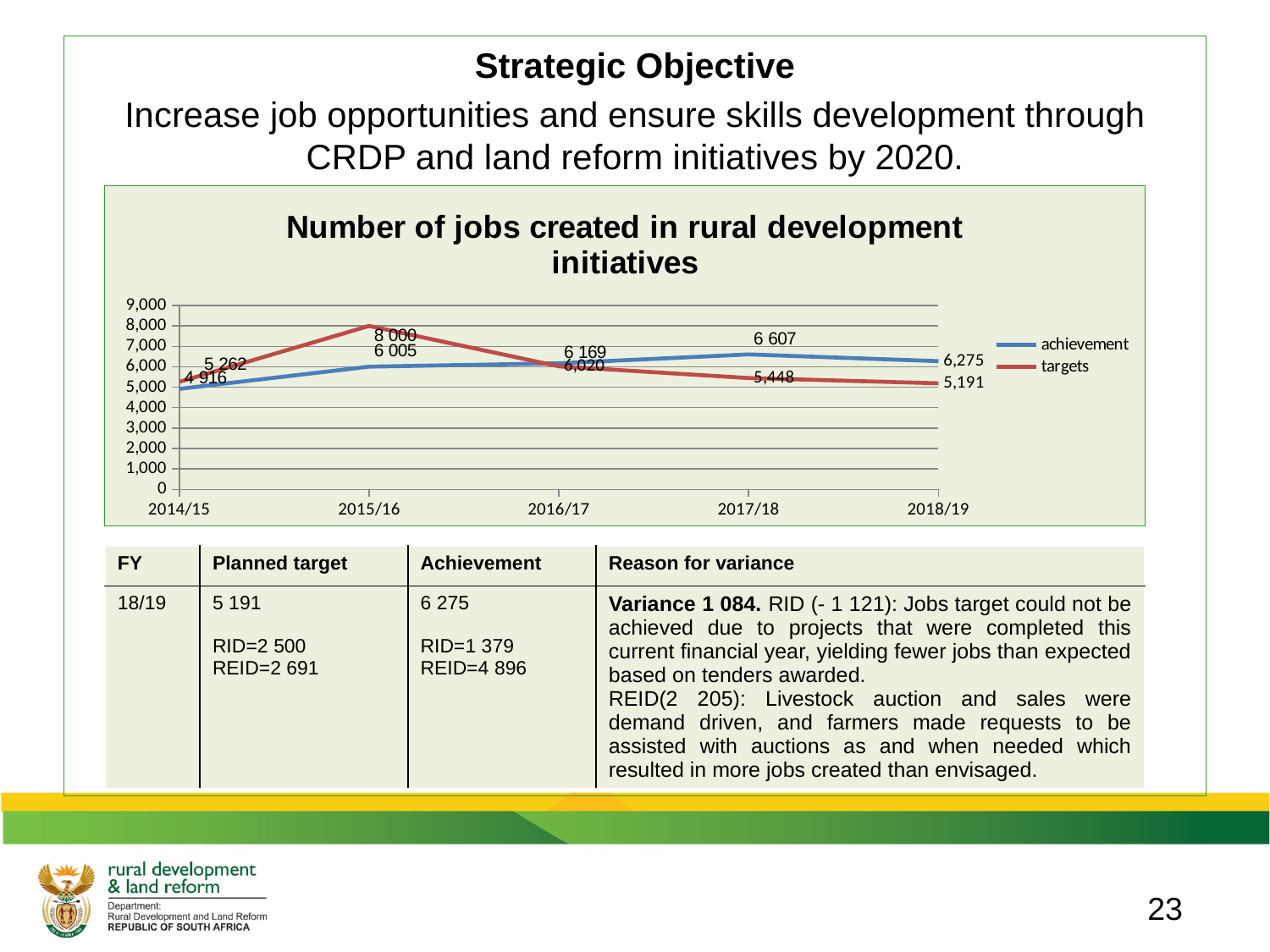
How many financial years are plotted along the x axis of the chart? 5 What is the achievement value for 2018/19? 6,275 What kind of chart is shown on the slide? line chart In which financial year is the achievement series highest? 2017/18 In 2015/16, which is larger: achievement or targets? targets How many series does the legend of the chart list? 2 What is the targets value for 2018/19? 5,191 In which financial year is the targets series highest? 2015/16 Does the targets series rise or fall from 2015/16 to 2018/19? fall What is the achievement value for 2014/15? 4 916 What is the targets value for 2015/16? 8 000 What is the difference between achievement and targets in 2018/19? 1,084